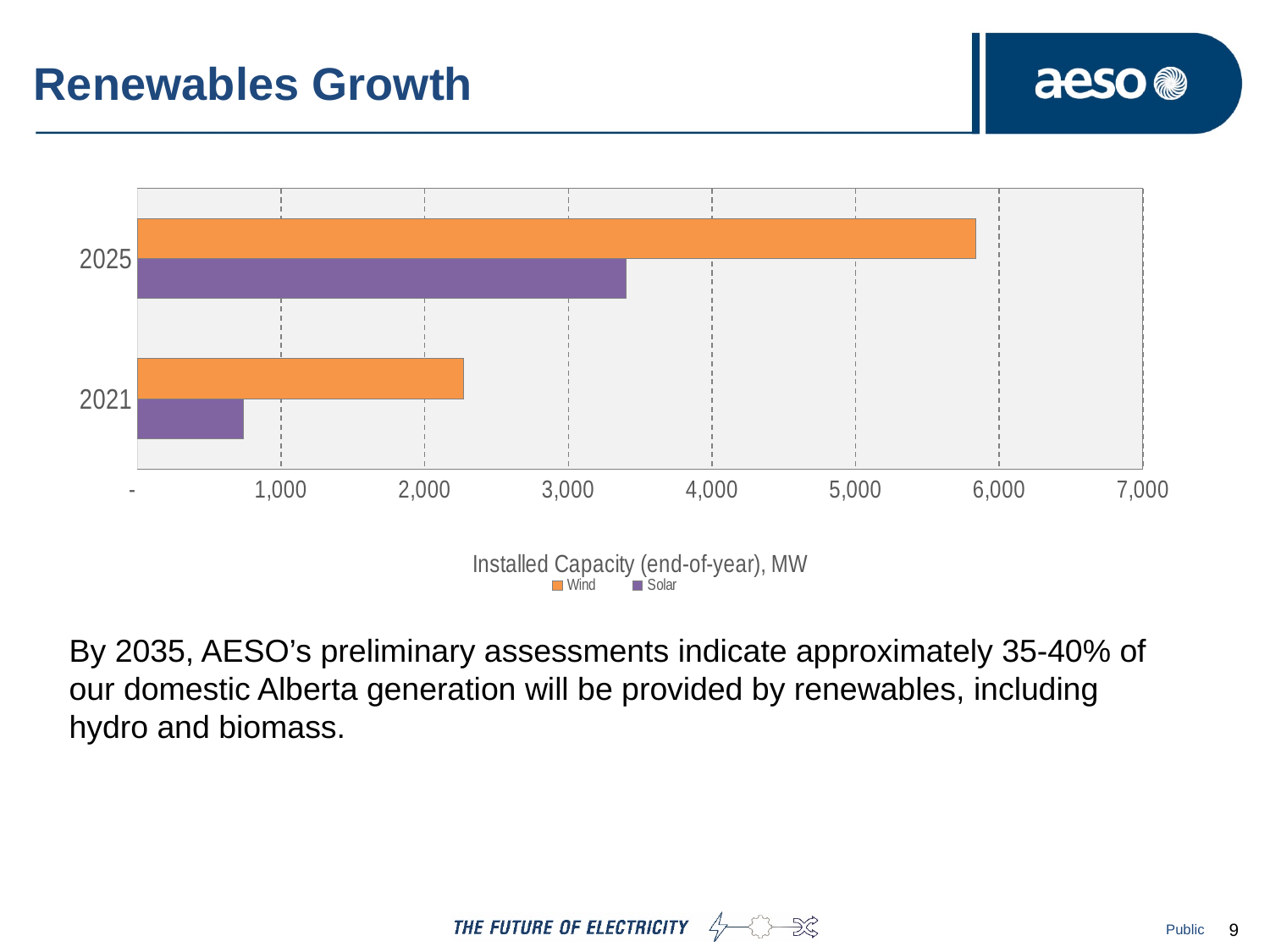
Do the Wind and Solar installed capacities rise or fall from 2021 to 2025? rise Which bar on the chart is the longest? Wind in 2025 Is the Solar value for 2021 greater or less than 1,000? less In 2025, which is larger, Wind or Solar installed capacity? Wind How many year categories are shown on the chart? 2 Is the Wind value for 2025 greater or less than 5,000? greater How many series does the chart's legend list? 2 What kind of chart is shown on the slide? bar chart Which bar on the chart is the shortest? Solar in 2021 Is the Wind value for 2021 greater or less than 2,000? greater What is the title of the chart's horizontal axis? Installed Capacity (end-of-year), MW